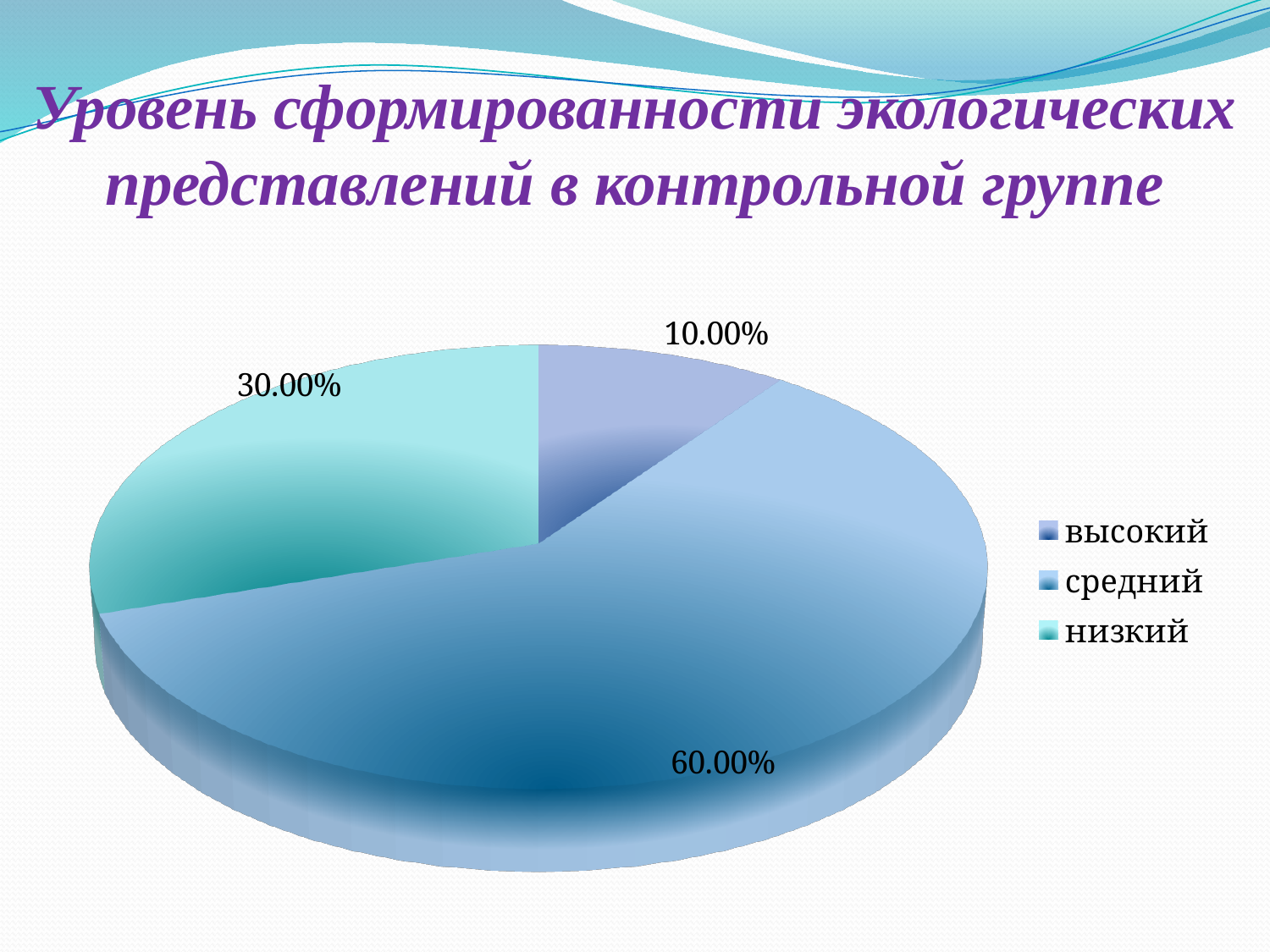
What is the difference between the 'средний' and 'низкий' slices? 30.00% Which category has the largest share of the pie? средний What kind of chart is shown on the slide? pie chart Which is larger, the 'низкий' slice or the 'высокий' slice? низкий What is the value for the 'средний' slice? 60.00% How many entries does the legend list? 3 How many slices does the pie chart have? 3 What is the value for the 'низкий' slice? 30.00% What is the difference between the 'низкий' and 'высокий' slices? 20.00% Which category has the smallest share of the pie? высокий What is the title of the slide containing the chart? Уровень сформированности экологических представлений в контрольной группе What is the value for the 'высокий' slice? 10.00%